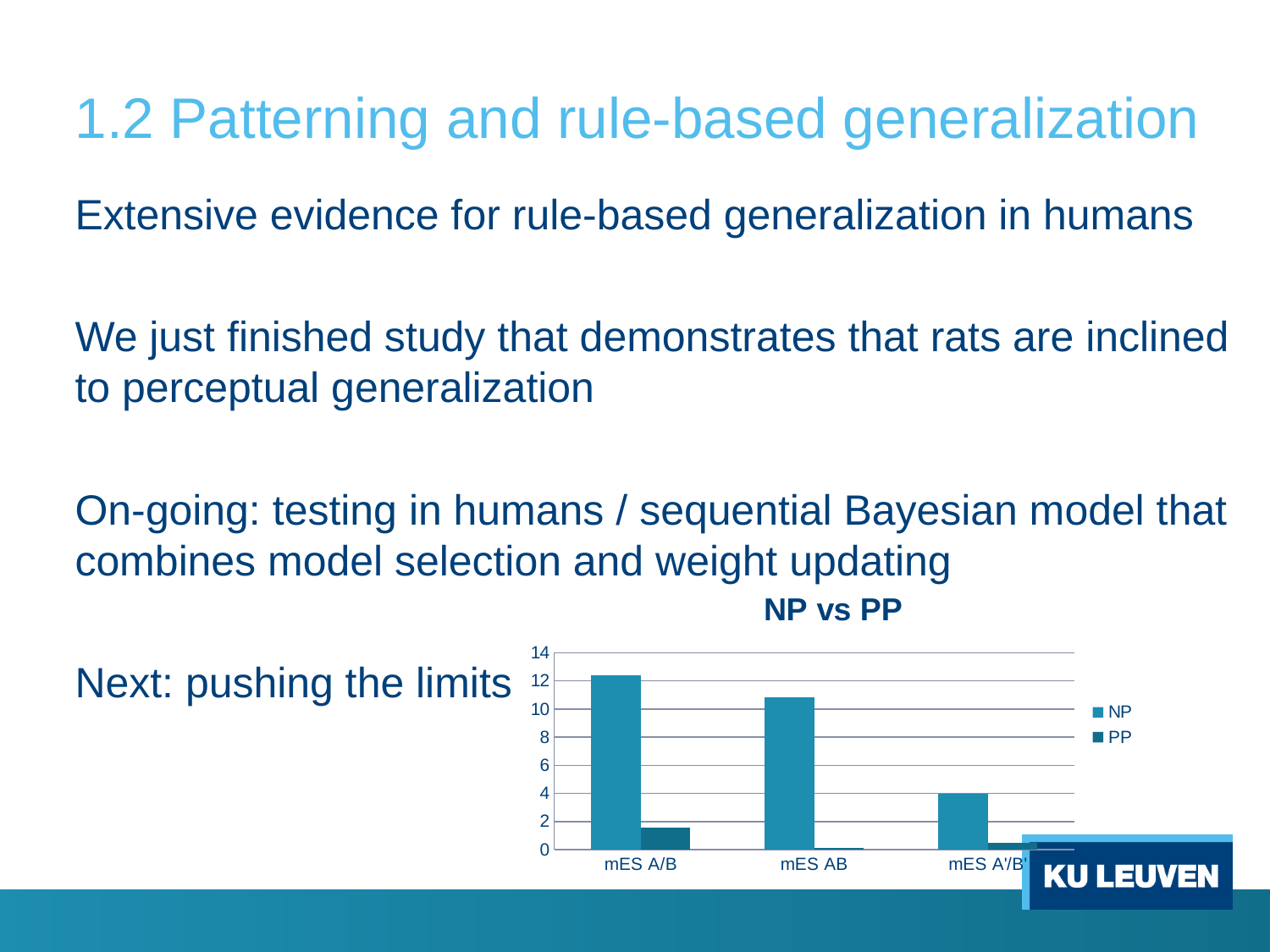
How many series does the chart's legend list? 2 Which category has the lowest NP value? mES A'/B' Which category has the highest NP value? mES A/B Is the NP value for mES A/B greater or less than 10? greater How many categories are shown on the x axis of the chart? 3 What kind of chart is shown on the slide? bar chart What is the title of the chart? NP vs PP Is the PP value for mES A/B greater or less than 4? less Do the NP values rise or fall from mES A/B to mES A'/B' along the x axis? fall Is the NP value for mES A'/B' greater or less than 6? less For mES A/B, which is larger, the NP value or the PP value? NP Which series are listed in the chart's legend? NP and PP